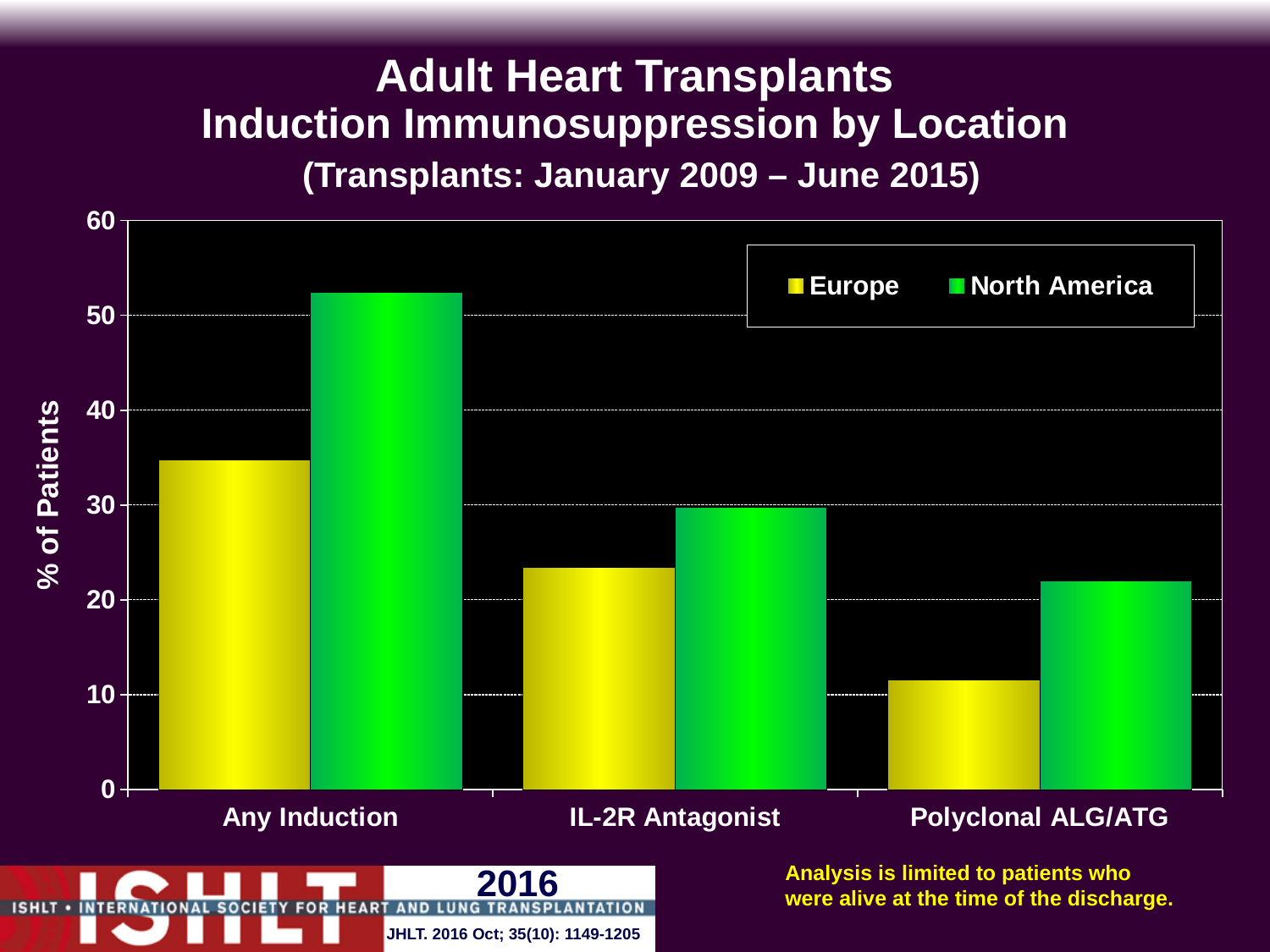
For Polyclonal ALG/ATG, which is larger: Europe or North America? North America How many series does the legend list? 2 Which category has the highest value for North America? Any Induction What kind of chart is shown on the slide? bar chart For Any Induction, which is larger: Europe or North America? North America Is the value for North America in Any Induction greater or less than 50? greater Which category has the lowest value for Europe? Polyclonal ALG/ATG Is the value for Europe in Any Induction greater or less than 30? greater Which series is shown in yellow? Europe What is the y-axis label of the chart? % of Patients How many categories are shown on the x axis? 3 Is the value for Europe in Polyclonal ALG/ATG greater or less than 20? less